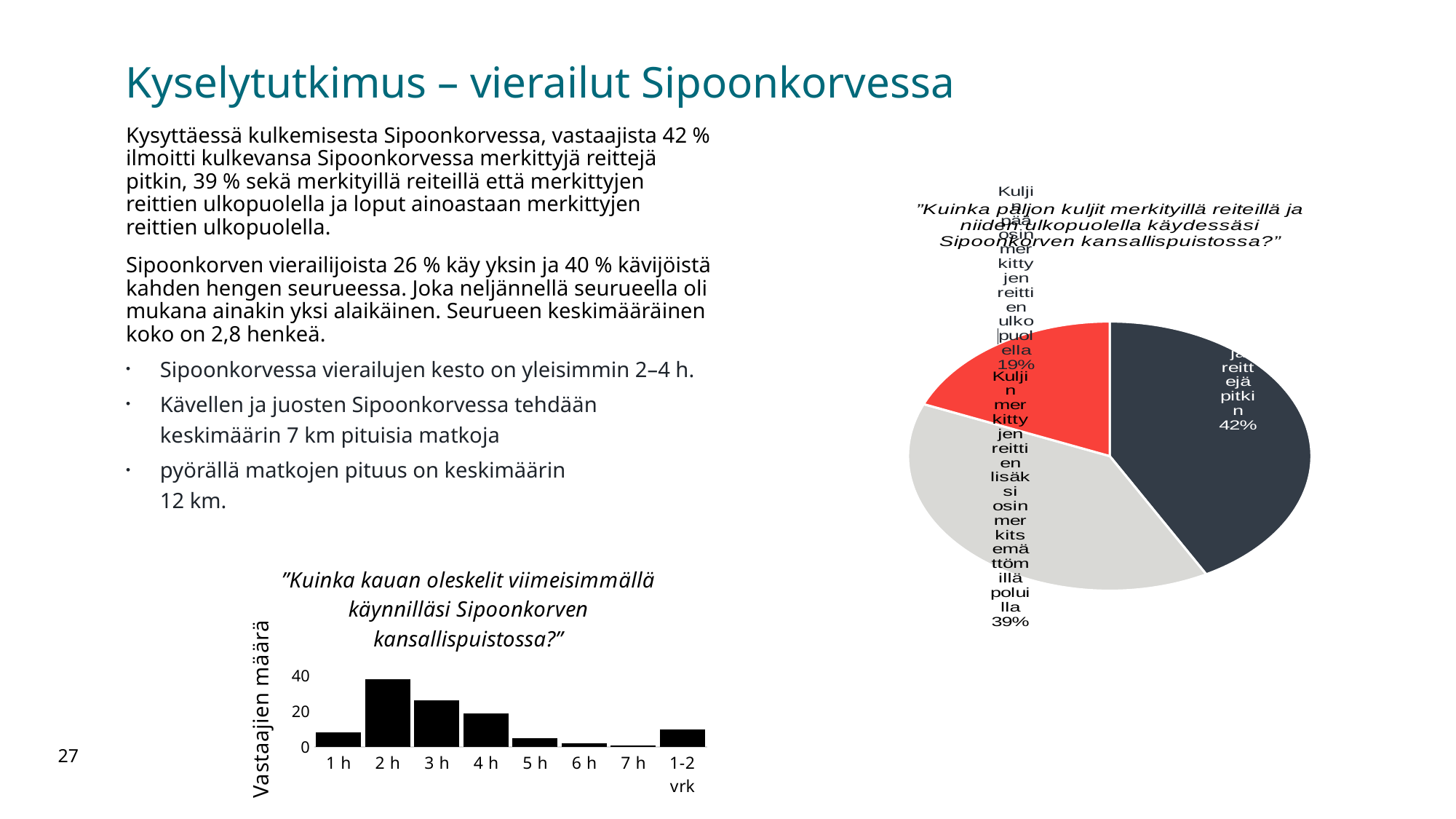
In the bar chart at the bottom left, which category has the highest number of respondents? 2 h In the pie chart on the right, what is the difference in percentage points between the largest slice (42%) and the smallest slice (19%)? 23 What kind of chart is the chart at the bottom left of the slide? bar chart In the bar chart at the bottom left, which is larger, the value for 3 h or the value for 5 h? 3 h In the pie chart on the right, what is the largest slice's share? 42% In the pie chart on the right, what is the smallest slice's share? 19% In the bar chart at the bottom left, is the value for 2 h greater or less than 20? greater In the bar chart at the bottom left, what is the label of the y axis? Vastaajien määrä What kind of chart is the chart on the right of the slide? pie chart In the bar chart at the bottom left, how many categories are shown on the x axis? 8 In the bar chart at the bottom left, which category has the lowest number of respondents? 7 h